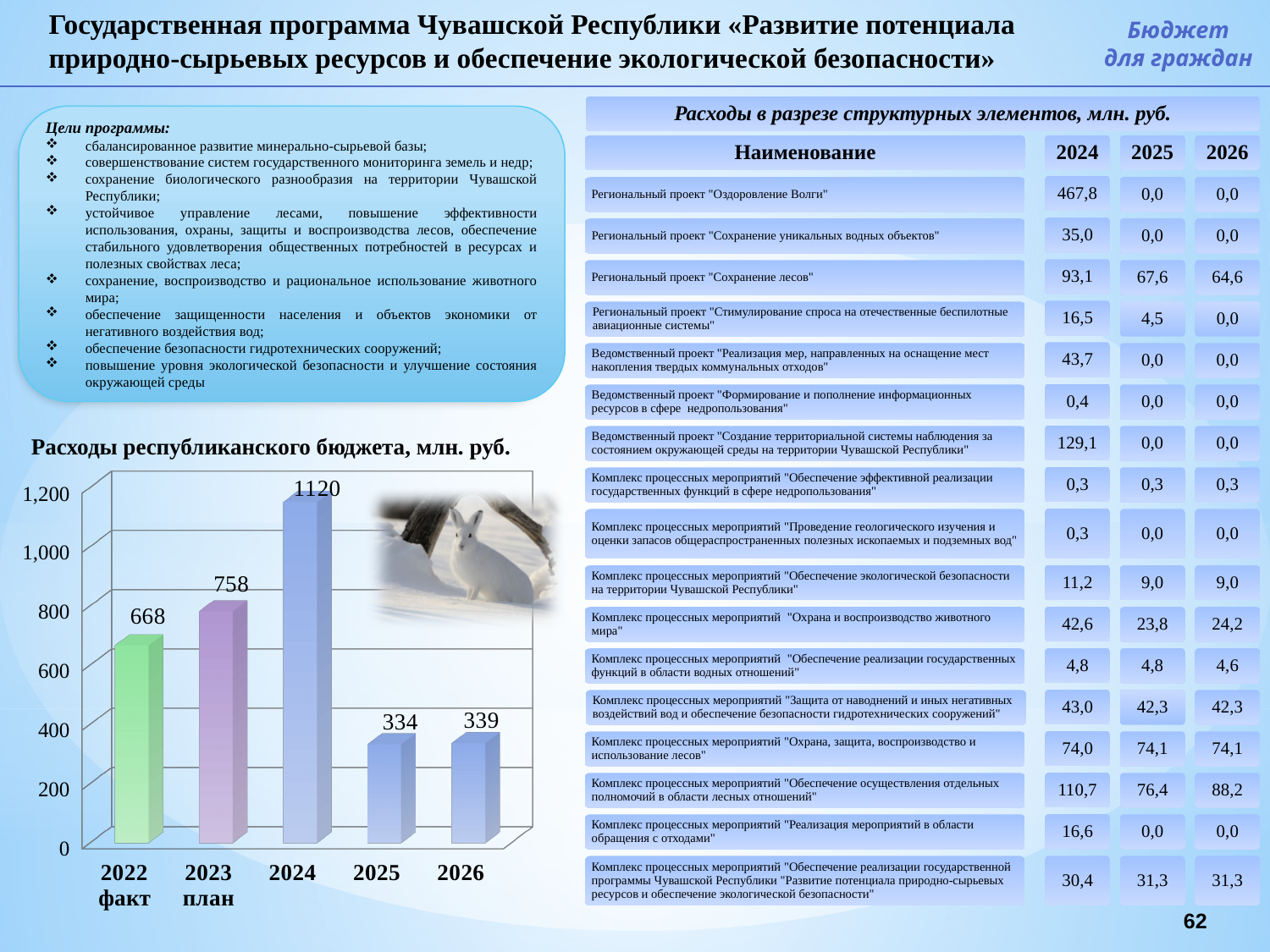
Is the value for 2024 in the chart "Расходы республиканского бюджета, млн. руб." greater or less than 1,000? greater What is the difference between the 2023 план and 2022 факт values in the chart "Расходы республиканского бюджета, млн. руб."? 90 What is the value for 2026 in the chart "Расходы республиканского бюджета, млн. руб."? 339 Which is larger in the chart "Расходы республиканского бюджета, млн. руб.": the value for 2022 факт or the value for 2025? 2022 факт What is the value for 2022 факт in the chart "Расходы республиканского бюджета, млн. руб."? 668 What is the value for 2024 in the chart "Расходы республиканского бюджета, млн. руб."? 1120 Which year has the highest value in the chart "Расходы республиканского бюджета, млн. руб."? 2024 What type of chart is "Расходы республиканского бюджета, млн. руб."? bar chart What is the difference between the 2024 and 2023 план values in the chart "Расходы республиканского бюджета, млн. руб."? 362 How many bars are shown in the chart "Расходы республиканского бюджета, млн. руб."? 5 Which year has the lowest value in the chart "Расходы республиканского бюджета, млн. руб."? 2025 In the chart "Расходы республиканского бюджета, млн. руб.", do the values rise or fall from 2024 to 2025? fall